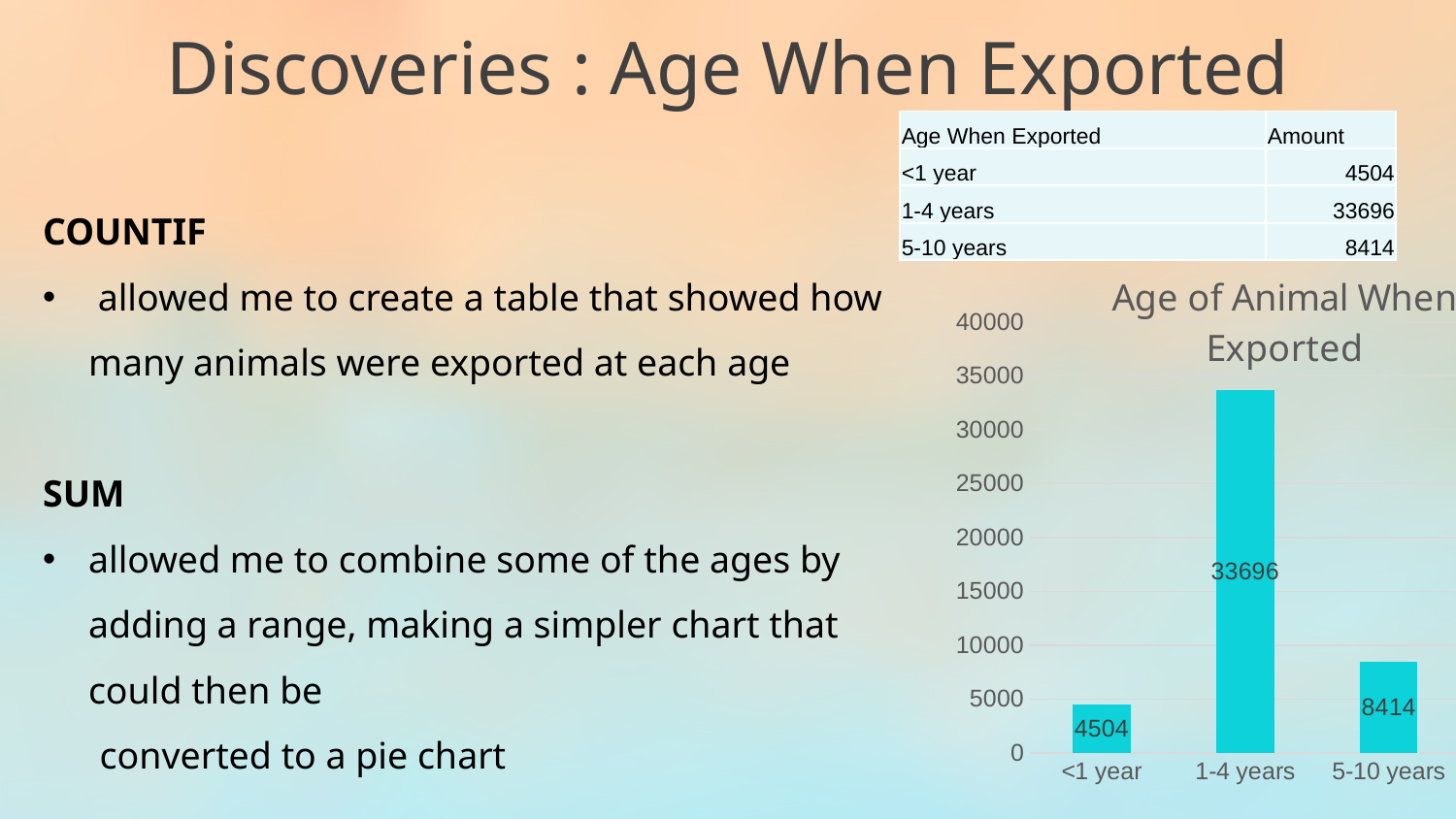
Which age group has the highest value? 1-4 years Which age group has the lowest value? <1 year Which is larger, the value for <1 year or the value for 5-10 years? 5-10 years What is the title of the chart? Age of Animal When Exported What is the difference between the values for 1-4 years and 5-10 years? 25282 What is the value for 1-4 years? 33696 How many age categories are shown in the chart? 3 What kind of chart is shown on the slide? bar chart What is the value for 5-10 years? 8414 Is the value for 1-4 years greater or less than 30000? greater What is the difference between the values for 5-10 years and <1 year? 3910 What is the value for <1 year? 4504